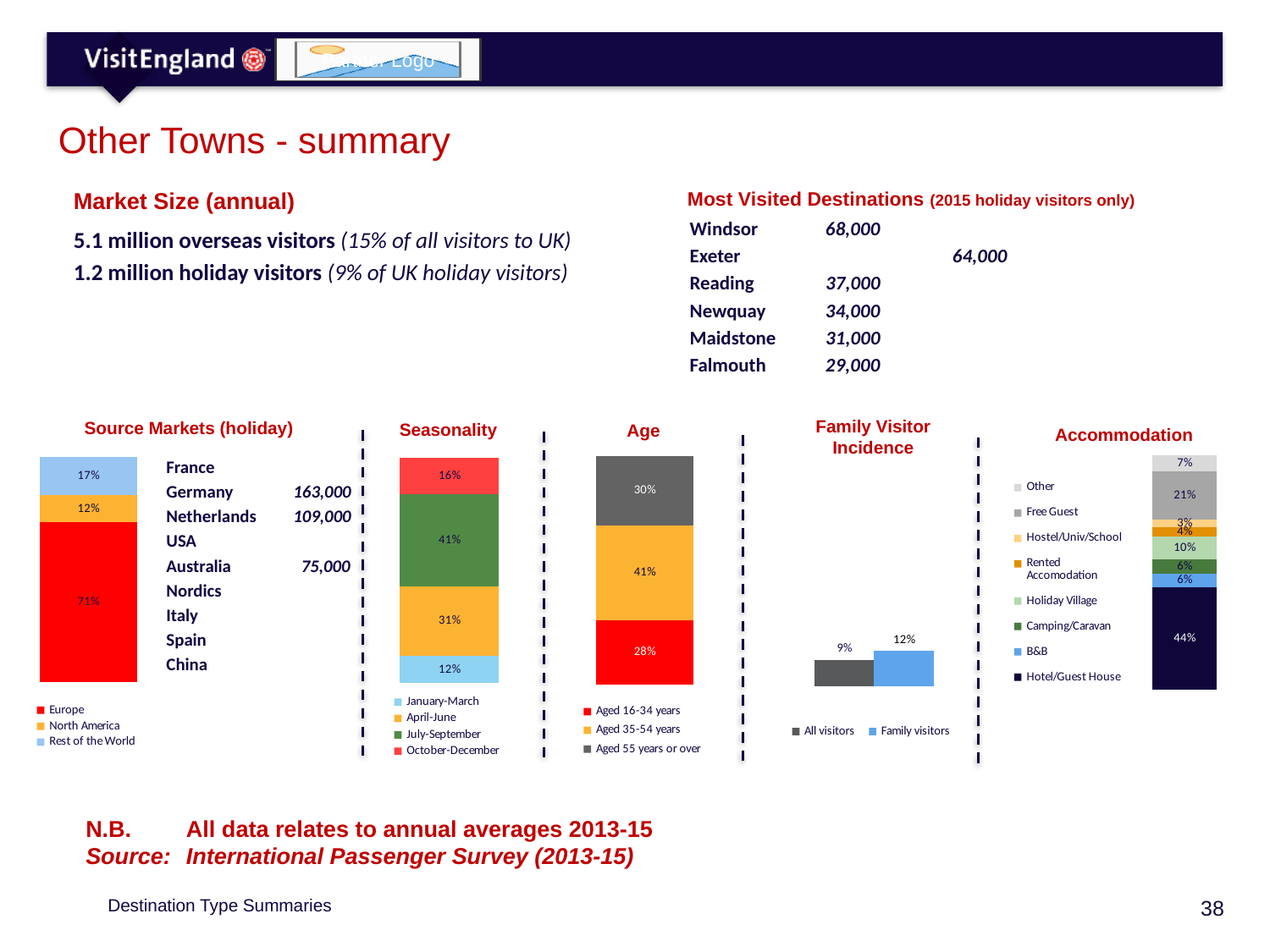
In the Age chart, what share of visitors are aged 35-54 years? 41% In the Source Markets (holiday) chart, what share of holiday visitors comes from Europe? 71% In the Source Markets (holiday) chart, which region has the smallest share? North America In the Family Visitor Incidence chart, what is the value for Family visitors? 12% In the Accommodation chart, what share of visitors stay in a Hotel/Guest House? 44% In the Family Visitor Incidence chart, what is the difference between Family visitors and All visitors? 3% In the Seasonality chart, what is the difference between the July-September and April-June shares? 10% In the Seasonality chart, which period has the lowest share of visits? January-March In the Seasonality chart, what percentage of visits occur in July-September? 41% In the Accommodation chart, what is the share for Free Guest? 21% In the Age chart, which is larger: the share aged 16-34 years or the share aged 55 years or over? Aged 55 years or over How many series does the legend of the Accommodation chart list? 8